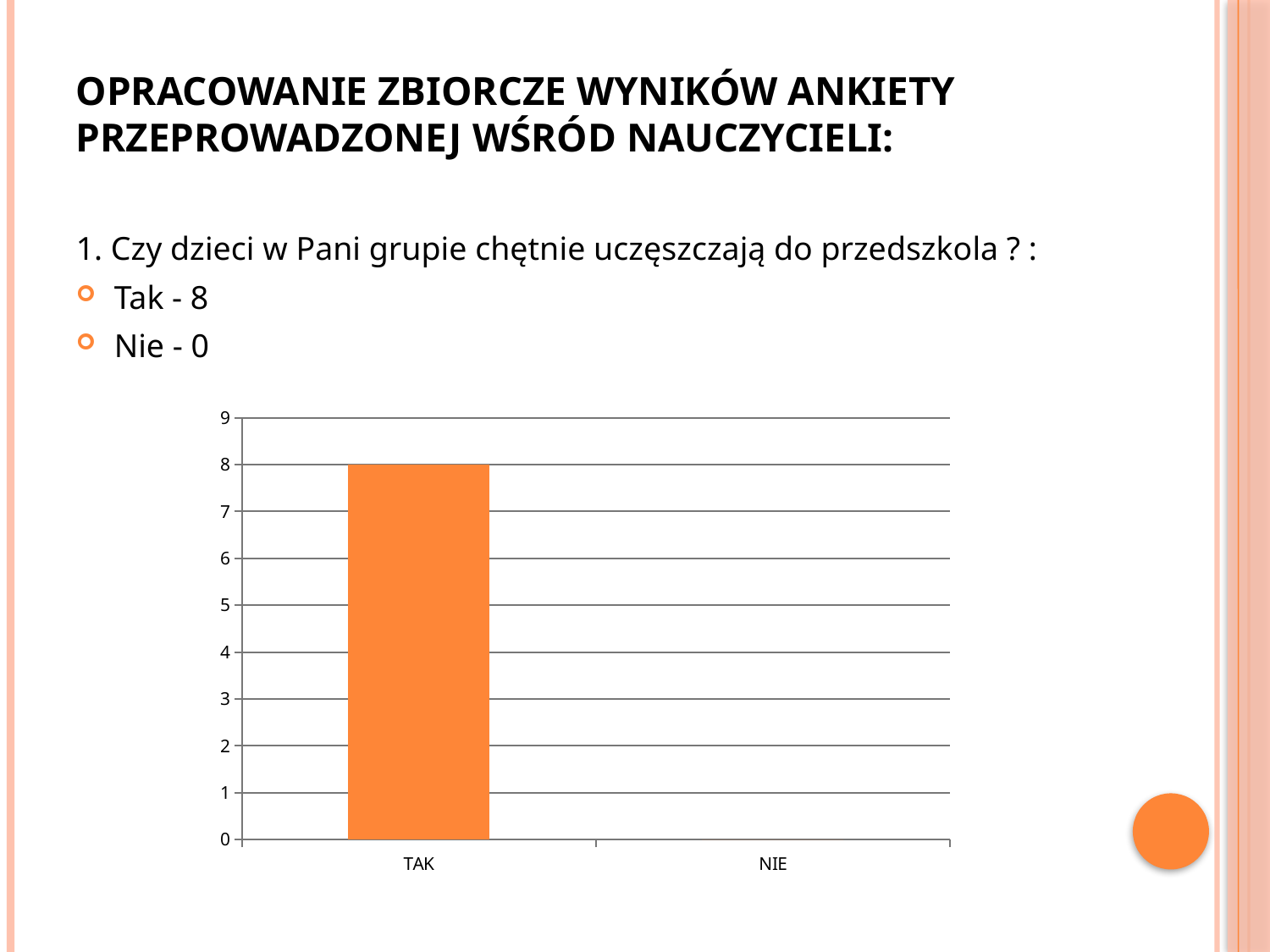
What is the difference between the values for TAK and NIE in the chart? 8 Which category has the highest value in the chart? TAK What is the total of the values for TAK and NIE in the chart? 8 Which is larger in the chart, the value for TAK or the value for NIE? TAK Which category has the lowest value in the chart? NIE What is the value for NIE in the chart? 0 What is the value of the TAK bar in the chart? 8 Is the value for TAK greater or less than 5? greater How many categories are shown on the x axis of the chart? 2 What colour is the TAK bar in the chart? orange What is the highest value shown on the vertical axis of the chart? 9 What kind of chart is shown on the slide? bar chart